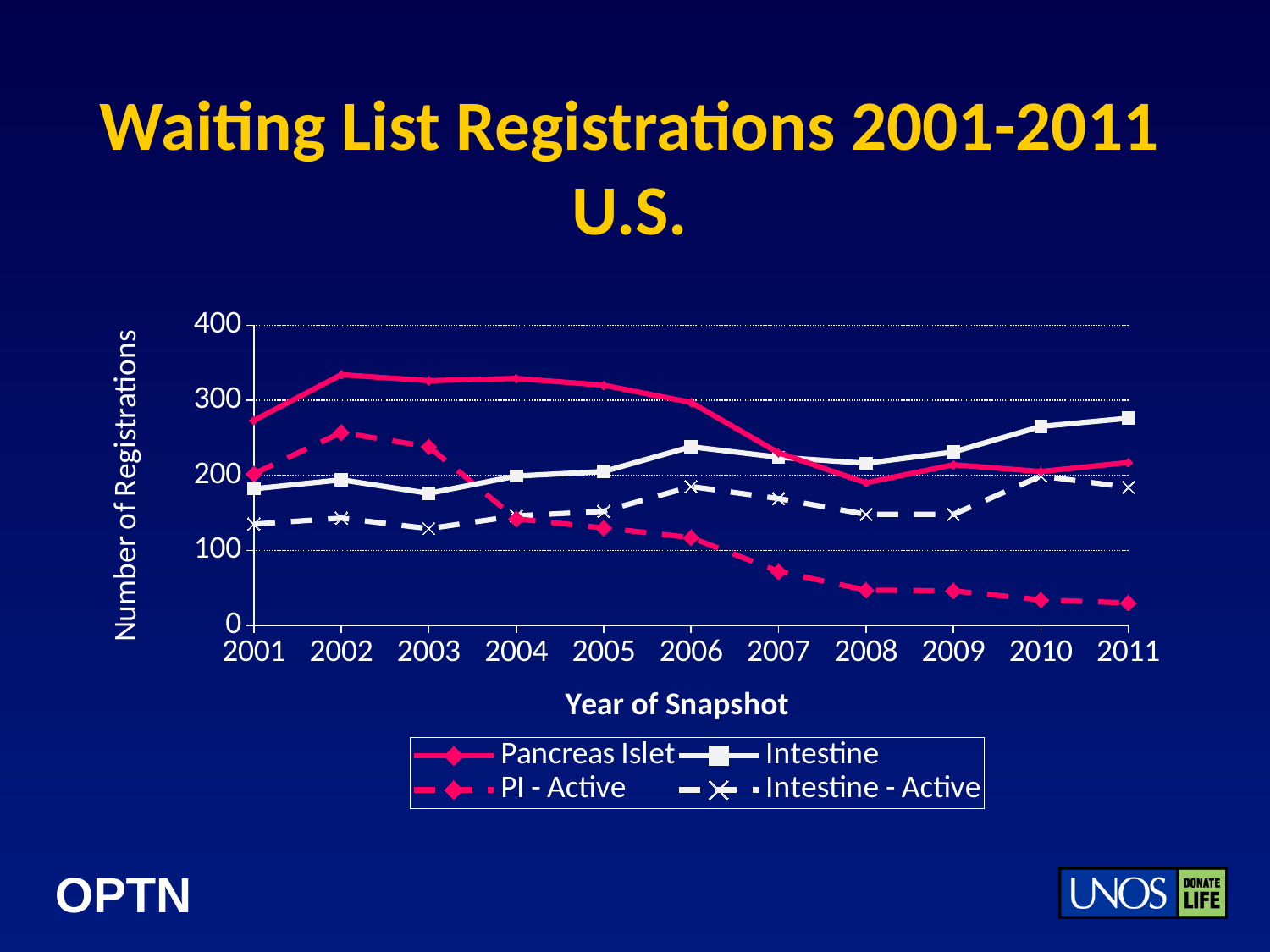
How many series does the legend list? 4 Is the value for Intestine in 2011 greater or less than 300? less Is the value for PI - Active in 2008 greater or less than 100? less In 2006, which series has the larger value, PI - Active or Intestine - Active? Intestine - Active In which year is the PI - Active series at its highest? 2002 How many years are plotted along the x axis? 11 What is the label of the y axis? Number of Registrations What kind of chart is shown on the slide? line chart Do the values for PI - Active rise or fall from 2003 to 2011? fall What is the title of the chart? Waiting List Registrations 2001-2011 U.S. Is the value for Pancreas Islet in 2002 greater or less than 300? greater In 2011, which series has the larger value, Intestine or Pancreas Islet? Intestine